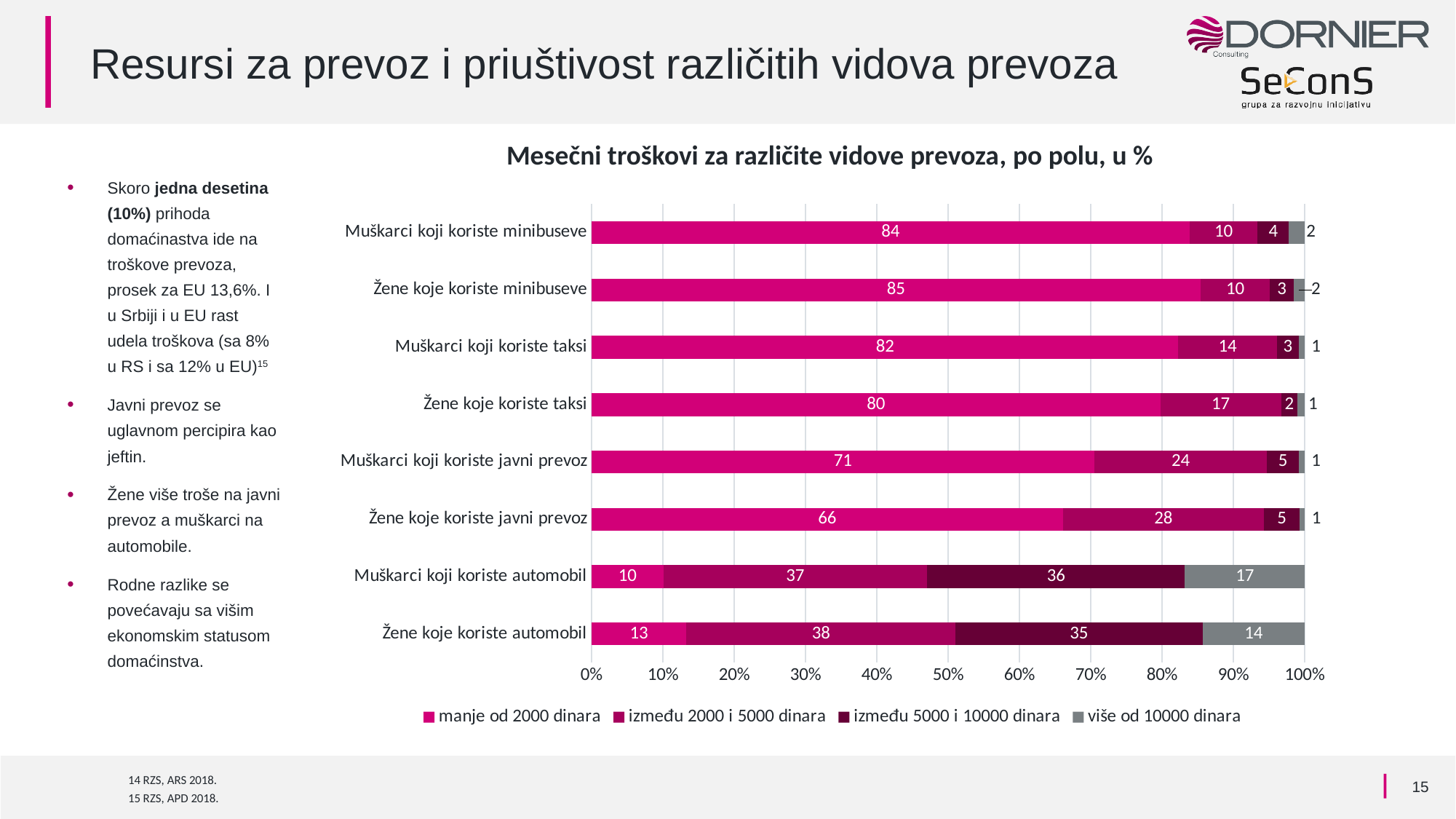
What is the total of the stacked bar for 'Muškarci koji koriste taksi'? 100 Which category has the lowest value for 'manje od 2000 dinara'? Muškarci koji koriste automobil Which has the larger value for 'između 5000 i 10000 dinara': 'Muškarci koji koriste automobil' or 'Žene koje koriste automobil'? Muškarci koji koriste automobil How many categories are shown on the chart? 8 What is the title of the chart? Mesečni troškovi za različite vidove prevoza, po polu, u % Which category has the highest value for 'manje od 2000 dinara'? Žene koje koriste minibuseve What is the value for 'između 2000 i 5000 dinara' for 'Muškarci koji koriste taksi'? 14 What kind of chart is shown on the slide? Stacked bar chart What is the value for 'više od 10000 dinara' for 'Muškarci koji koriste automobil'? 17 What is the difference between the 'između 2000 i 5000 dinara' values for 'Žene koje koriste javni prevoz' and 'Muškarci koji koriste javni prevoz'? 4 How many series does the legend list? 4 What is the value for 'manje od 2000 dinara' for 'Žene koje koriste javni prevoz'? 66